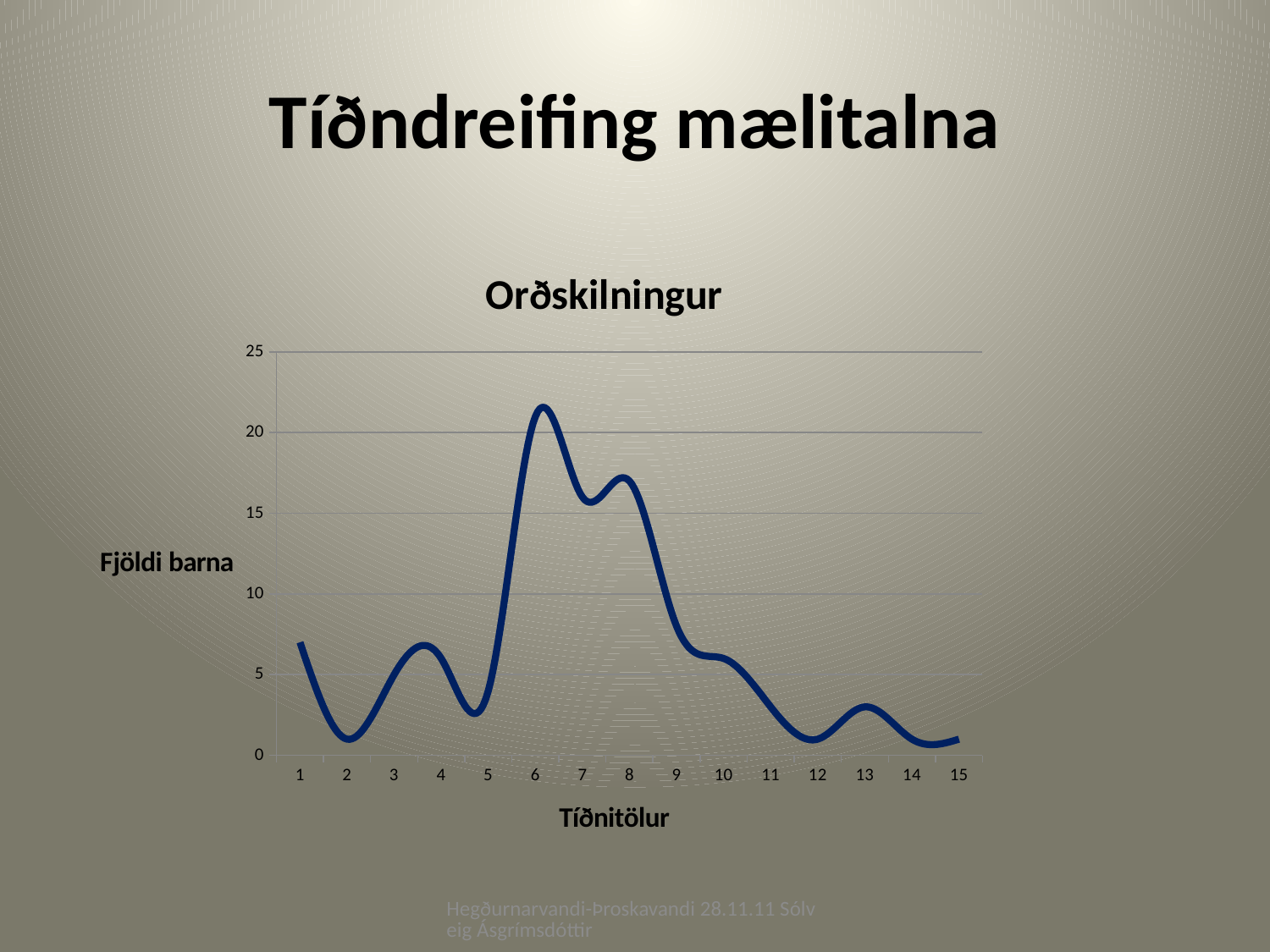
Is the value at Tíðnitölur 2 greater or less than 5? less Is the value at Tíðnitölur 12 greater or less than 5? less Is the value at Tíðnitölur 8 greater or less than 15? greater What is the label on the vertical axis of the chart? Fjöldi barna How many points are plotted along the x axis (Tíðnitölur)? 15 What is the title of the chart? Orðskilningur Which has the larger value, Tíðnitölur 6 or Tíðnitölur 8? 6 What kind of chart is shown on the slide? line chart Does the line rise or fall from Tíðnitölur 9 to Tíðnitölur 12? fall At which Tíðnitölur value does the line reach its highest point? 6